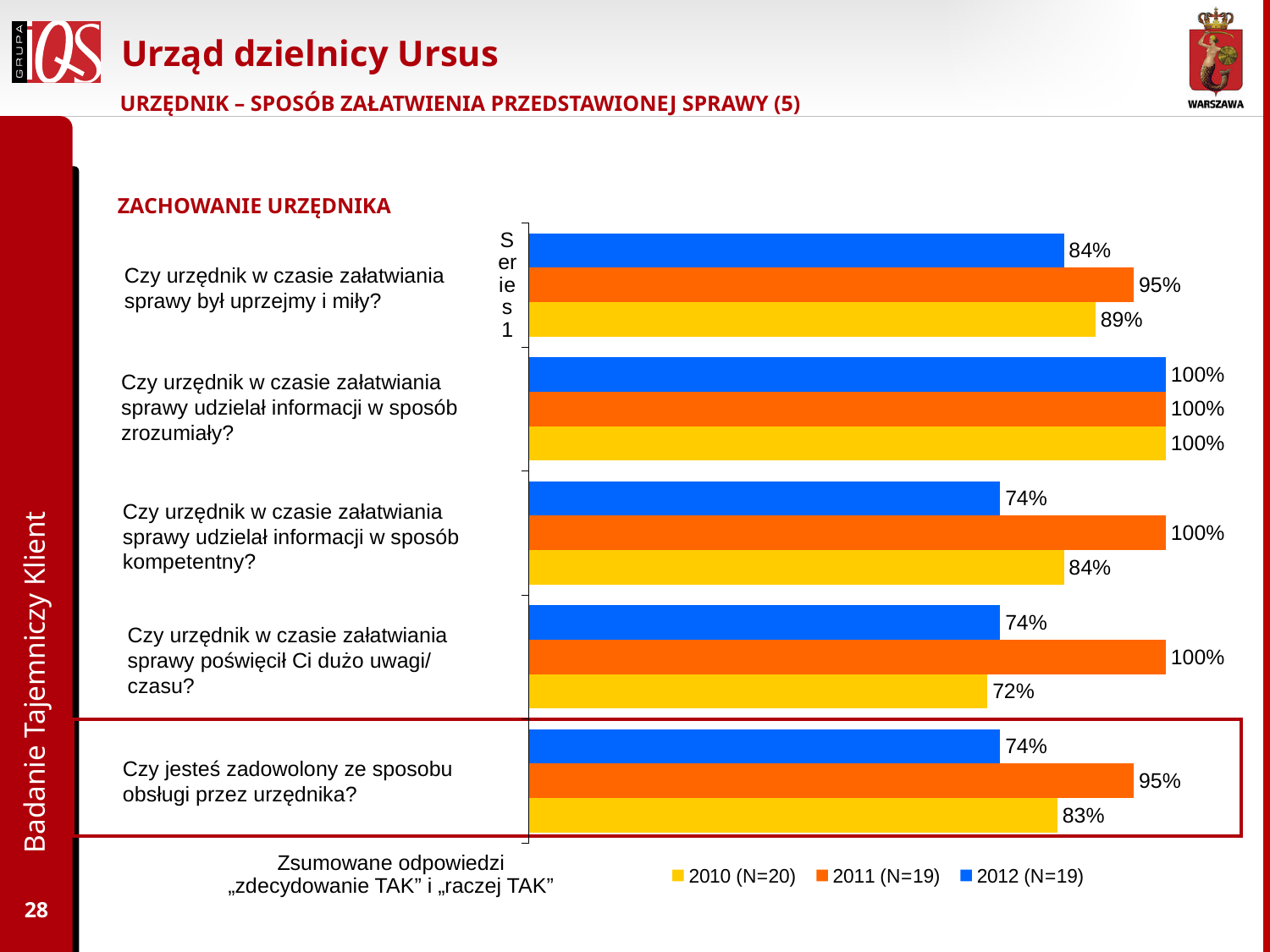
How many series does the legend list? 3 For "Czy jesteś zadowolony ze sposobu obsługi przez urzędnika?", which year has the lowest value? 2012 (N=19) What is the 2011 (N=19) value for "Czy urzędnik w czasie załatwiania sprawy był uprzejmy i miły?"? 95% Which colour represents the 2011 (N=19) series in the legend? orange What value do all three years show for "Czy urzędnik w czasie załatwiania sprawy udzielał informacji w sposób zrozumiały?"? 100% What is the 2010 (N=20) value for "Czy urzędnik w czasie załatwiania sprawy poświęcił Ci dużo uwagi/ czasu?"? 72% What kind of chart is shown on the slide? bar chart What is the 2012 (N=19) value for "Czy jesteś zadowolony ze sposobu obsługi przez urzędnika?"? 74% How many question categories are plotted in the chart? 5 For "Czy urzędnik w czasie załatwiania sprawy udzielał informacji w sposób kompetentny?", which year has the highest value? 2011 (N=19) What is the difference between the 2011 (N=19) and 2012 (N=19) values for "Czy jesteś zadowolony ze sposobu obsługi przez urzędnika?"? 21% Which is larger for "Czy urzędnik w czasie załatwiania sprawy był uprzejmy i miły?": the 2010 (N=20) value or the 2012 (N=19) value? 2010 (N=20)